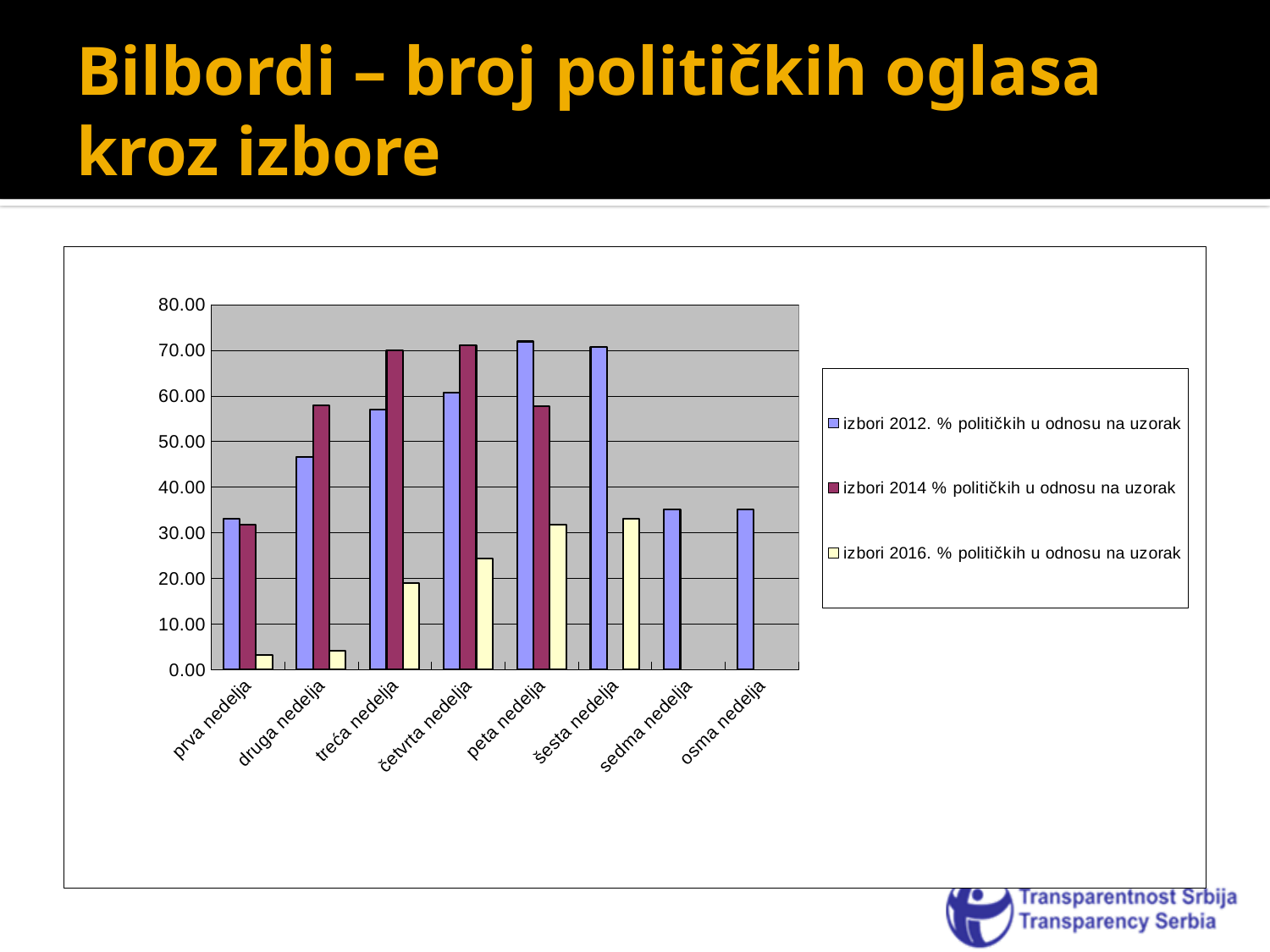
Is the value for 'izbori 2014 % političkih u odnosu na uzorak' in druga nedelja greater or less than 50? greater How many categories (weeks) are shown on the x axis? 8 Is the value for 'izbori 2012. % političkih u odnosu na uzorak' in sedma nedelja greater or less than 40? less Is the value for 'izbori 2012. % političkih u odnosu na uzorak' in druga nedelja greater or less than 50? less Do the values for 'izbori 2016. % političkih u odnosu na uzorak' rise or fall from prva nedelja to šesta nedelja? rise In treća nedelja, which series has the larger value: izbori 2012 or izbori 2014? izbori 2014 In druga nedelja, which series has the larger value: izbori 2012 or izbori 2014? izbori 2014 Which series has a bar in every one of the eight weeks? izbori 2012. % političkih u odnosu na uzorak What kind of chart is shown on the slide? bar chart How many series does the legend list? 3